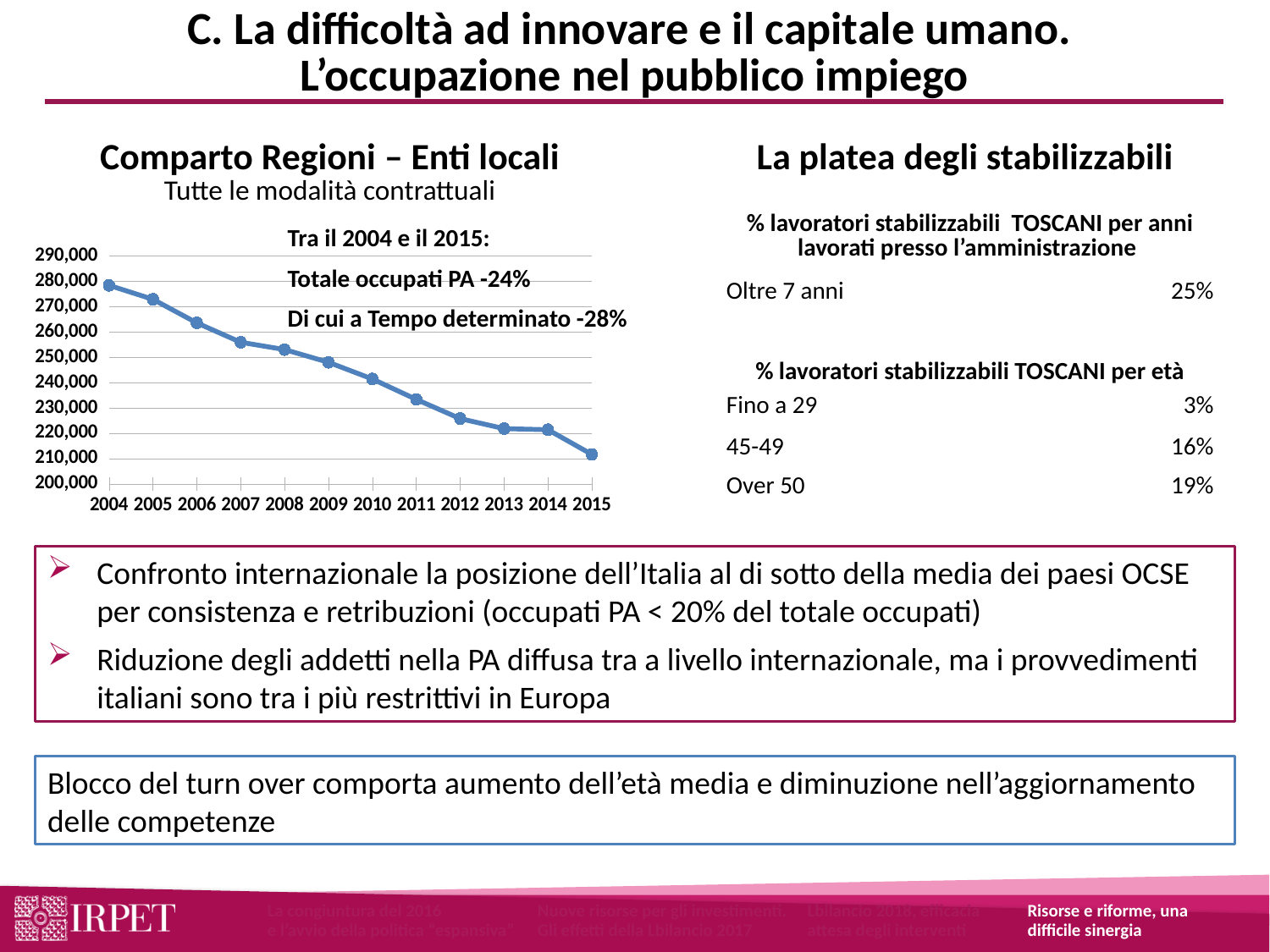
According to the annotation on the chart, by what percentage did "Totale occupati PA" change between 2004 and 2015? -24% In the "Comparto Regioni – Enti locali" chart, is the value for 2004 greater or less than 270,000? greater In the "Comparto Regioni – Enti locali" chart, is the value for 2010 greater or less than 250,000? less How many years are plotted on the x axis of the "Comparto Regioni – Enti locali" chart? 12 In the "Comparto Regioni – Enti locali" chart, which year has the larger value, 2007 or 2011? 2007 In the "Comparto Regioni – Enti locali" chart, do the values rise or fall from 2004 to 2015? fall What is the subtitle shown under the chart heading "Comparto Regioni – Enti locali"? Tutte le modalità contrattuali What kind of chart is shown under the heading "Comparto Regioni – Enti locali"? line chart Which year has the lowest value in the "Comparto Regioni – Enti locali" chart? 2015 Which year has the highest value in the "Comparto Regioni – Enti locali" chart? 2004 In the "Comparto Regioni – Enti locali" chart, is the value for 2015 greater or less than 220,000? less